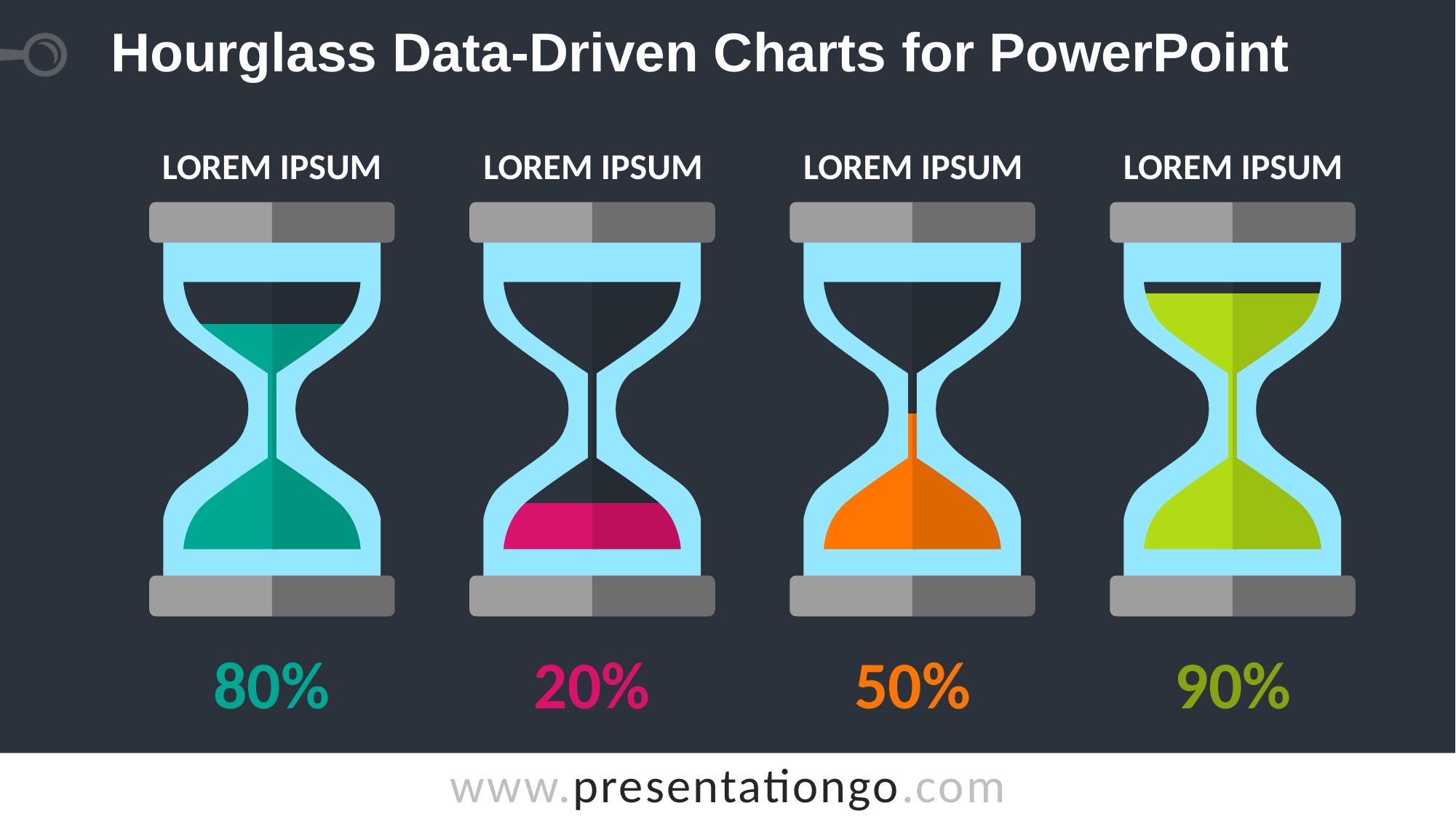
Which is larger, the value of the orange hourglass or the pink hourglass? The orange hourglass (50%) What is the title of the slide? Hourglass Data-Driven Charts for PowerPoint What value is shown below the fourth (rightmost) hourglass? 90% Which hourglass shows the highest percentage? The fourth (rightmost, green) hourglass, 90% What colour is the fill of the hourglass showing 50%? Orange What value is shown below the first (leftmost) hourglass? 80% Which hourglass shows the lowest percentage? The second (pink) hourglass, 20% What value is shown below the second hourglass from the left? 20% How many hourglass charts are shown on the slide? 4 What is the difference between the value of the first hourglass and the second hourglass? 60% What value is shown below the third hourglass from the left? 50% What is the difference between the value of the rightmost hourglass and the leftmost hourglass? 10%